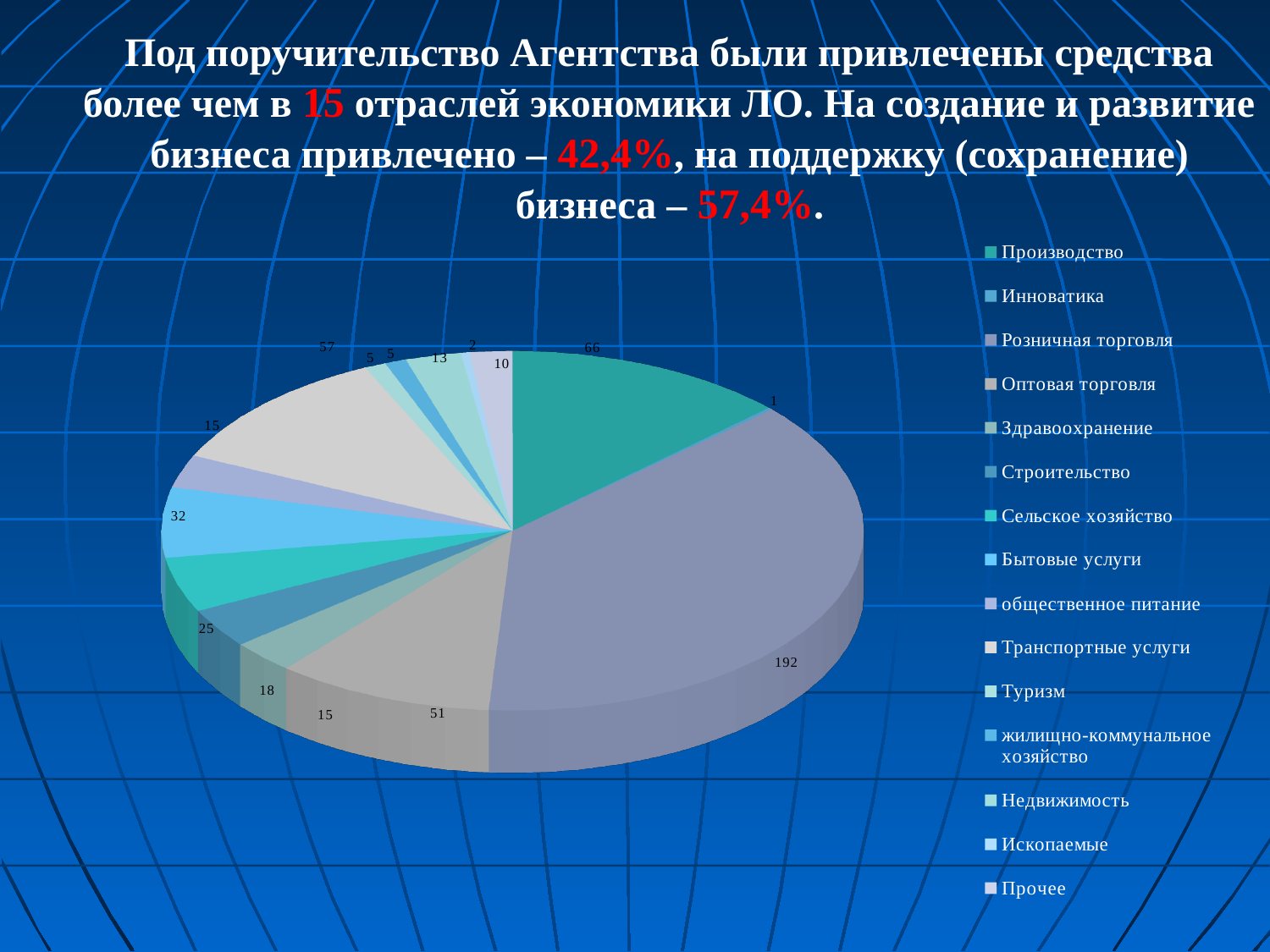
What is the value for Розничная торговля on the pie chart? 192 What is the difference between the value for Розничная торговля (192) and the value for Производство (66)? 126 What is the total of all the values labelled on the pie chart? 507 How many categories does the legend of the pie chart list? 15 Which category has the largest slice of the pie chart? Розничная торговля What percentage of the total does the slice labelled 192 represent? 37.9% Which is larger on the pie chart, the slice for Розничная торговля or the slice for Производство? Розничная торговля Which legend entry is listed last in the pie chart's legend? Прочее What is the largest value labelled on the pie chart? 192 What is the value for Производство on the pie chart? 66 What is the smallest value labelled on the pie chart? 1 What kind of chart is shown on the slide? pie chart